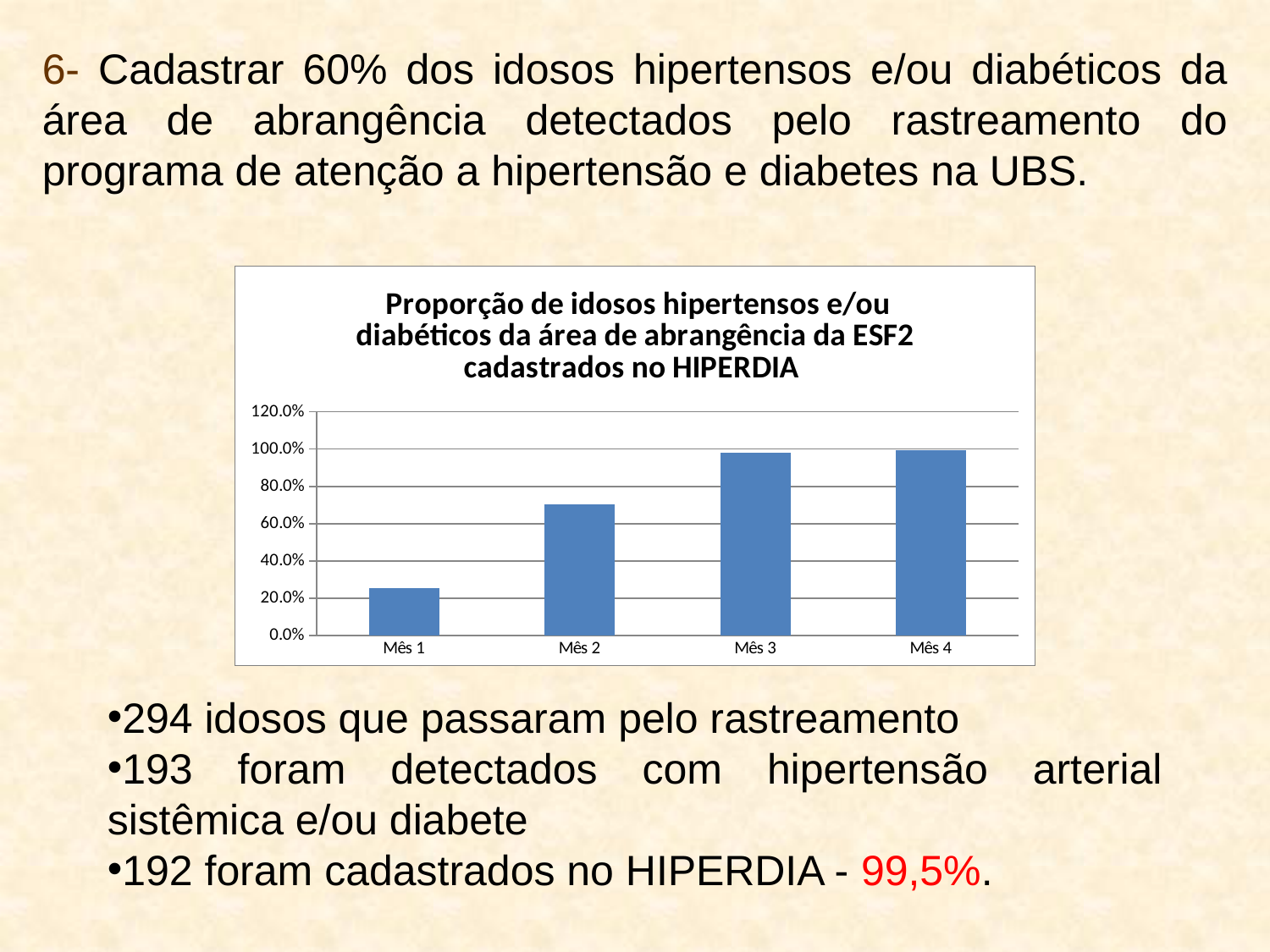
What is the highest tick value shown on the vertical axis of the chart? 120.0% What kind of chart is shown on the slide? bar chart Is the value for Mês 2 greater or less than 80.0%? less Is the value for Mês 2 greater or less than 60.0%? greater Is the value for Mês 4 greater or less than 80.0%? greater Which is larger, the value for Mês 2 or the value for Mês 3? Mês 3 Which month has the lowest proportion of elderly registered in HIPERDIA? Mês 1 Do the values rise or fall from Mês 1 to Mês 4? rise Which is larger, the value for Mês 1 or the value for Mês 2? Mês 2 How many months (categories) are plotted on the chart? 4